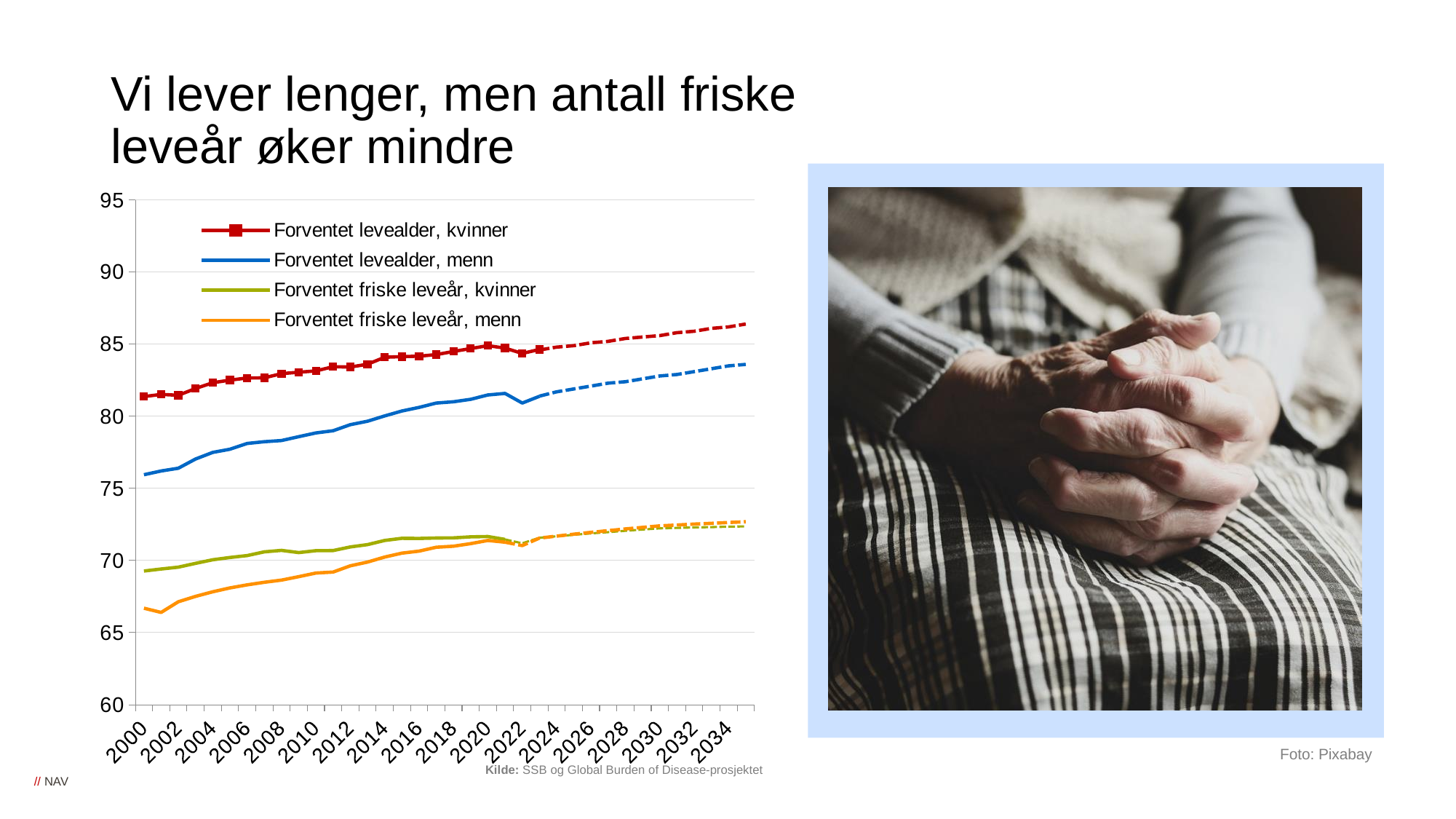
Does Forventet levealder, menn rise or fall from 2000 to 2034? rise Which series is plotted in red? Forventet levealder, kvinner What kind of chart is shown on the slide? line chart Which series has the lowest value in 2000? Forventet friske leveår, menn Is the value for Forventet levealder, menn in 2000 greater or less than 80? less Is the value for Forventet levealder, kvinner in 2034 greater or less than 85? greater Which series has the highest values across the whole chart? Forventet levealder, kvinner Is the value for Forventet friske leveår, kvinner in 2020 greater or less than 70? greater How many series does the chart's legend list? 4 Which series is plotted in orange? Forventet friske leveår, menn